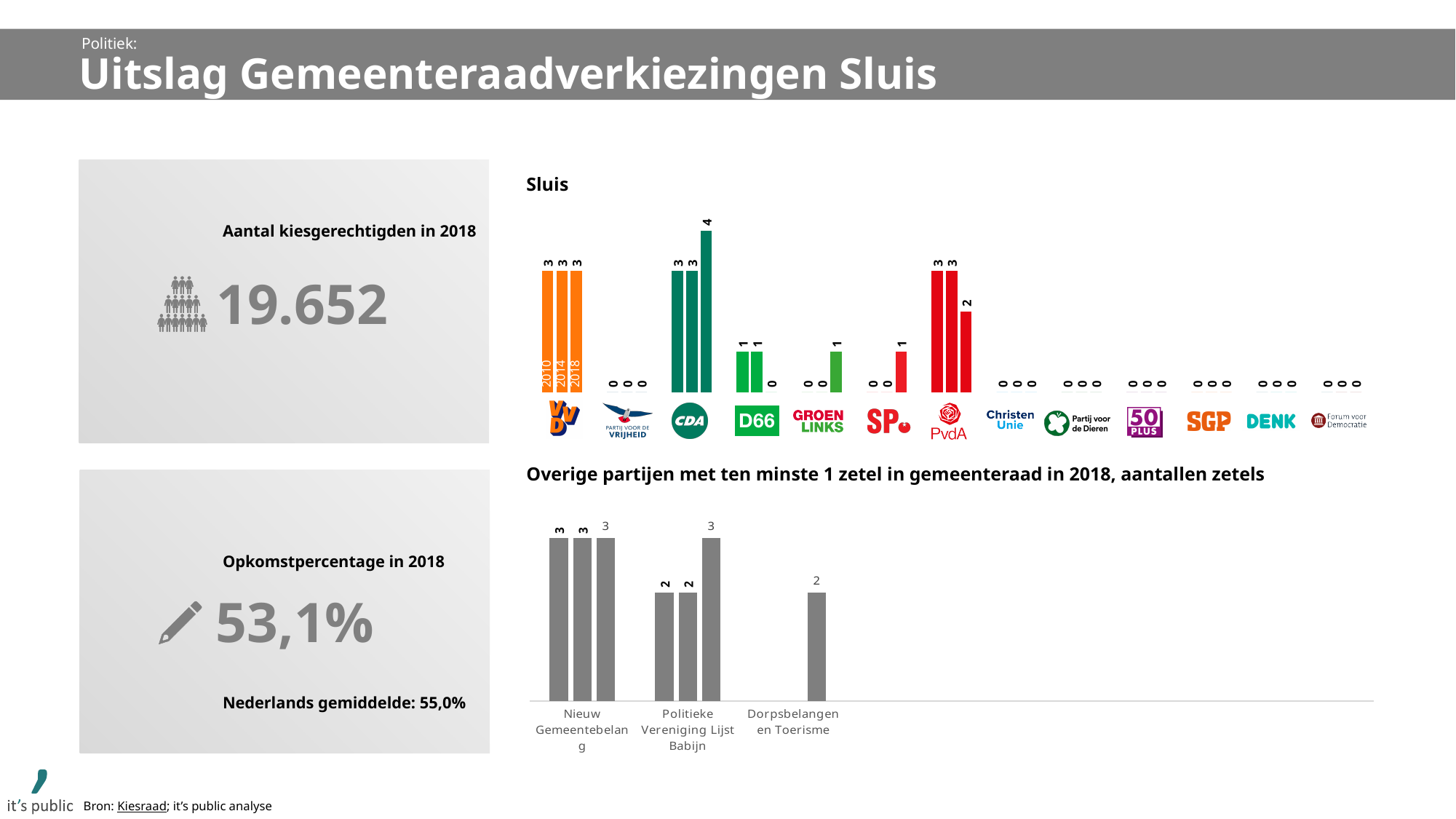
In the 'Sluis' chart, how many seats did PvdA have in 2018? 2 In the 'Sluis' chart, how many years are shown per party? 3 What type of chart is the 'Overige partijen' chart? bar chart In the 'Sluis' chart, how many seats did VVD have in 2010? 3 In the 'Sluis' chart, how many seats did D66 have in 2018? 0 In the 'Sluis' chart, how many seats did CDA win in 2018? 4 In the 'Overige partijen' chart, how many seats did Dorpsbelangen en Toerisme have in 2018? 2 In the 'Overige partijen' chart, how many parties are shown? 3 In the 'Sluis' chart, what is the difference between CDA's seats in 2018 and in 2014? 1 In the 'Overige partijen' chart, how many seats did Politieke Vereniging Lijst Babijn have in 2018? 3 In the 'Sluis' chart, which party had the most seats in 2018? CDA In the 'Sluis' chart, did PvdA's seats rise or fall from 2014 to 2018? fall